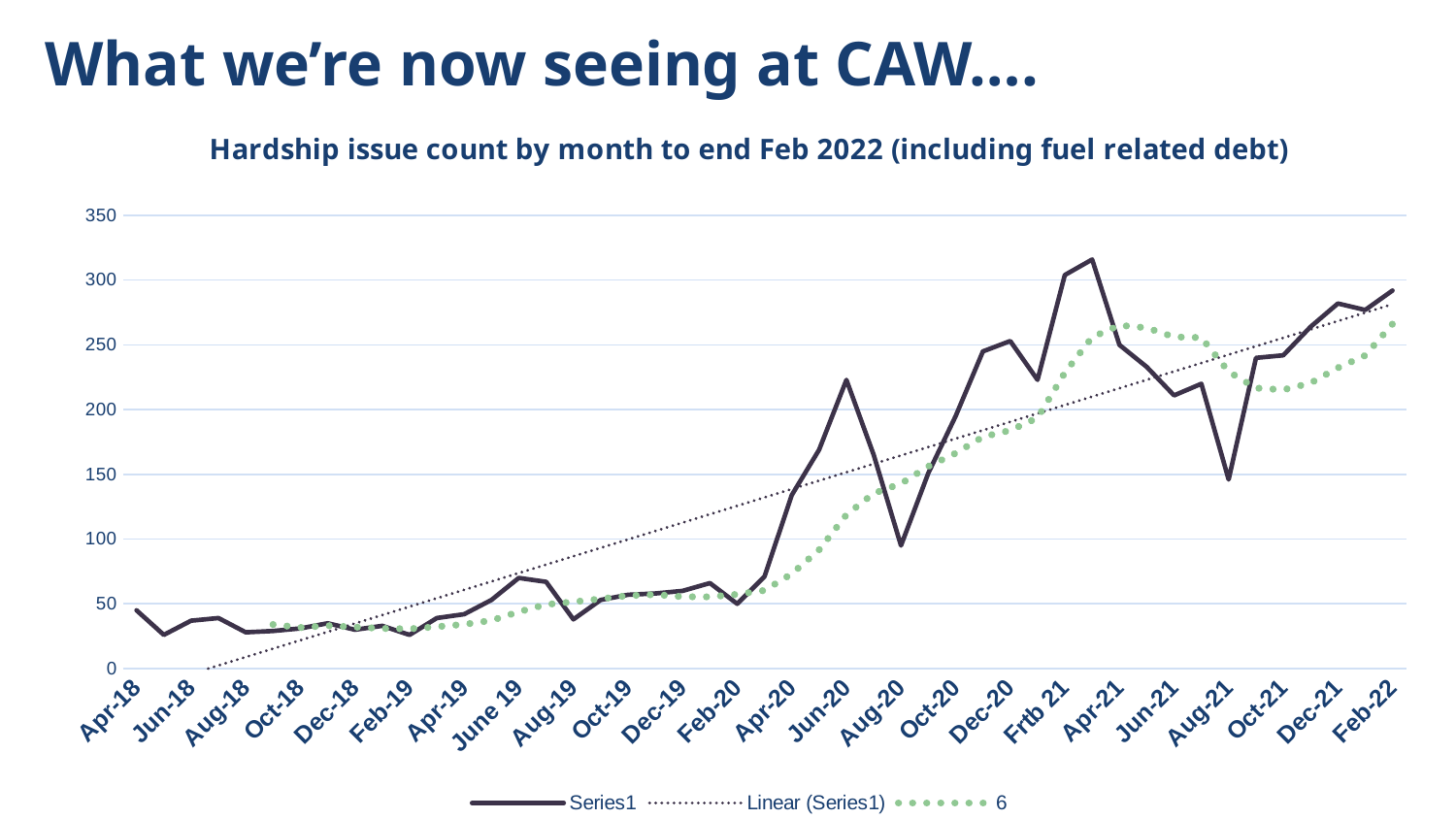
Overall, do the Series1 values rise or fall from Apr-18 to Feb-22? rise How many entries does the chart legend list? 3 What is the highest value shown on the vertical axis? 350 Which has the larger Series1 value, Apr-18 or Feb-22? Feb-22 What kind of chart is shown on the slide? line chart Is the Series1 value for Jun-20 greater or less than 200? greater Is the Series1 value for Feb-22 greater or less than 250? greater Which has the larger Series1 value, Jun-20 or Aug-20? Jun-20 Is the Series1 value for Aug-20 greater or less than 150? less What is the title of the chart? Hardship issue count by month to end Feb 2022 (including fuel related debt)